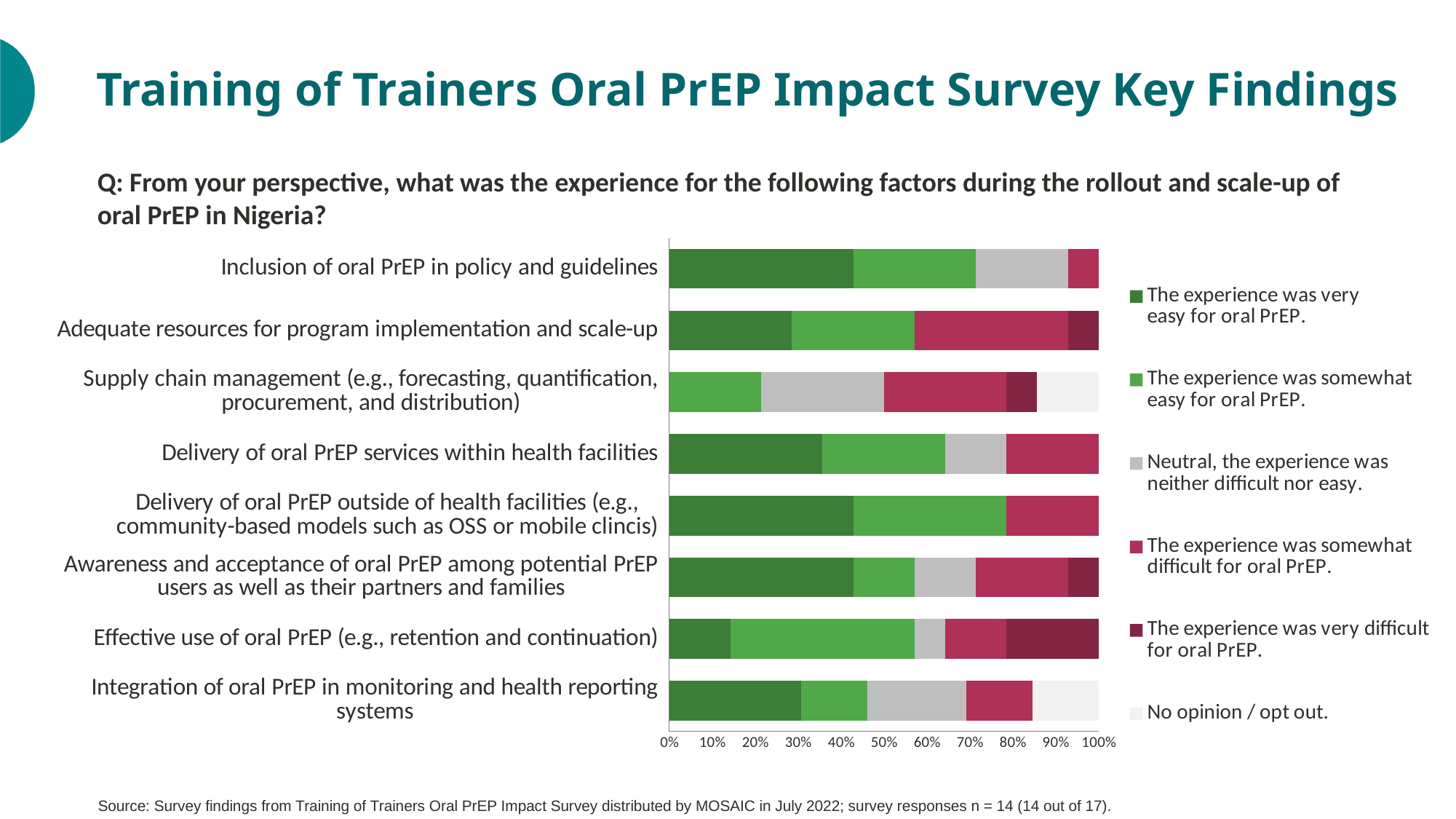
How many factors (categories) are plotted on the chart? 8 Is the 'Neutral' share for 'Supply chain management' greater or less than 20%? greater Which factor has the largest 'The experience was very difficult for oral PrEP' segment? Effective use of oral PrEP (e.g., retention and continuation) Which response option is shown in the darkest green colour in the legend? The experience was very easy for oral PrEP. How many response options does the legend list? 6 Which factor has no 'The experience was very easy for oral PrEP' segment at all? Supply chain management (e.g., forecasting, quantification, procurement, and distribution) How many factors include a 'No opinion / opt out' segment? 2 Which has the larger 'somewhat easy' share: 'Effective use of oral PrEP' or 'Integration of oral PrEP in monitoring and health reporting systems'? Effective use of oral PrEP Is the 'somewhat difficult' share for 'Adequate resources for program implementation and scale-up' greater or less than 30%? greater Is the 'No opinion / opt out' share for 'Integration of oral PrEP in monitoring and health reporting systems' greater or less than 20%? less What kind of chart is shown on the slide? Stacked bar chart